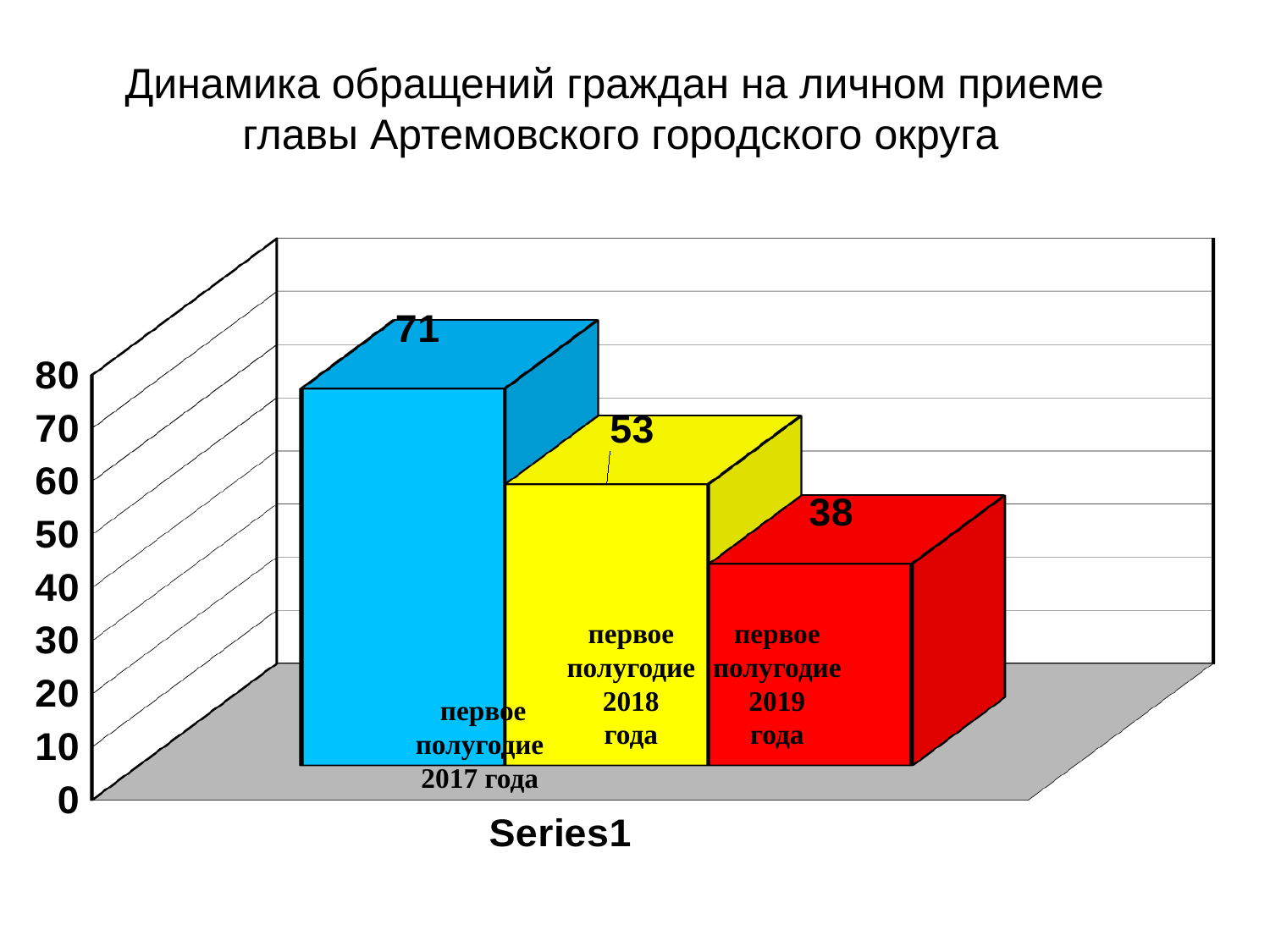
Which period has the lowest value? первое полугодие 2019 года Do the values rise or fall from 2017 to 2019? fall Which is larger, the value for первое полугодие 2018 года or первое полугодие 2019 года? первое полугодие 2018 года What colour is the bar for первое полугодие 2019 года? red Which period has the highest value? первое полугодие 2017 года What kind of chart is shown on the slide? bar chart What is the difference between the values for первое полугодие 2017 года and первое полугодие 2019 года? 33 What is the value for первое полугодие 2019 года? 38 What is the difference between the values for первое полугодие 2018 года and первое полугодие 2019 года? 15 What is the value for первое полугодие 2018 года? 53 How many bars are shown in the chart? 3 What is the value for первое полугодие 2017 года? 71